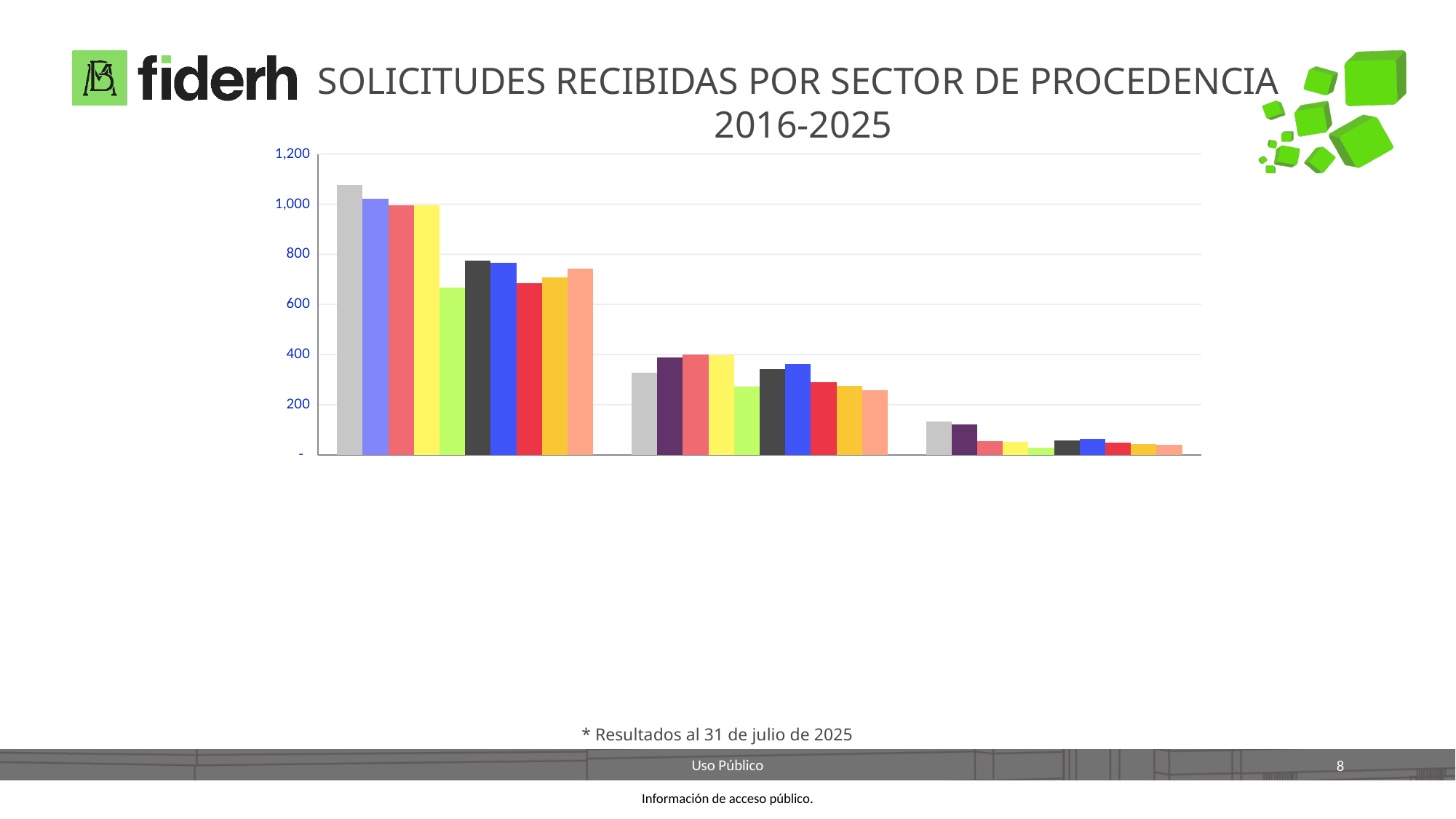
What is the highest tick value shown on the vertical axis? 1,200 Is the first (gray) bar of the leftmost group taller or shorter than the first (gray) bar of the middle group? taller What kind of chart is shown on the slide? bar chart Is the tallest bar in the rightmost group greater or less than 200? less How many groups of bars are plotted along the x axis? 3 How many bars are there in each group? 10 Is the tallest bar in the leftmost group greater or less than 1,000? greater Which group of bars has the shortest bars: the leftmost, the middle, or the rightmost? rightmost Is the tallest bar in the middle group greater or less than 600? less What is the title of the chart on the slide? SOLICITUDES RECIBIDAS POR SECTOR DE PROCEDENCIA 2016-2025 Which group of bars has the tallest bars: the leftmost, the middle, or the rightmost? leftmost Do the bar heights generally rise or fall moving from the leftmost group to the rightmost group? fall